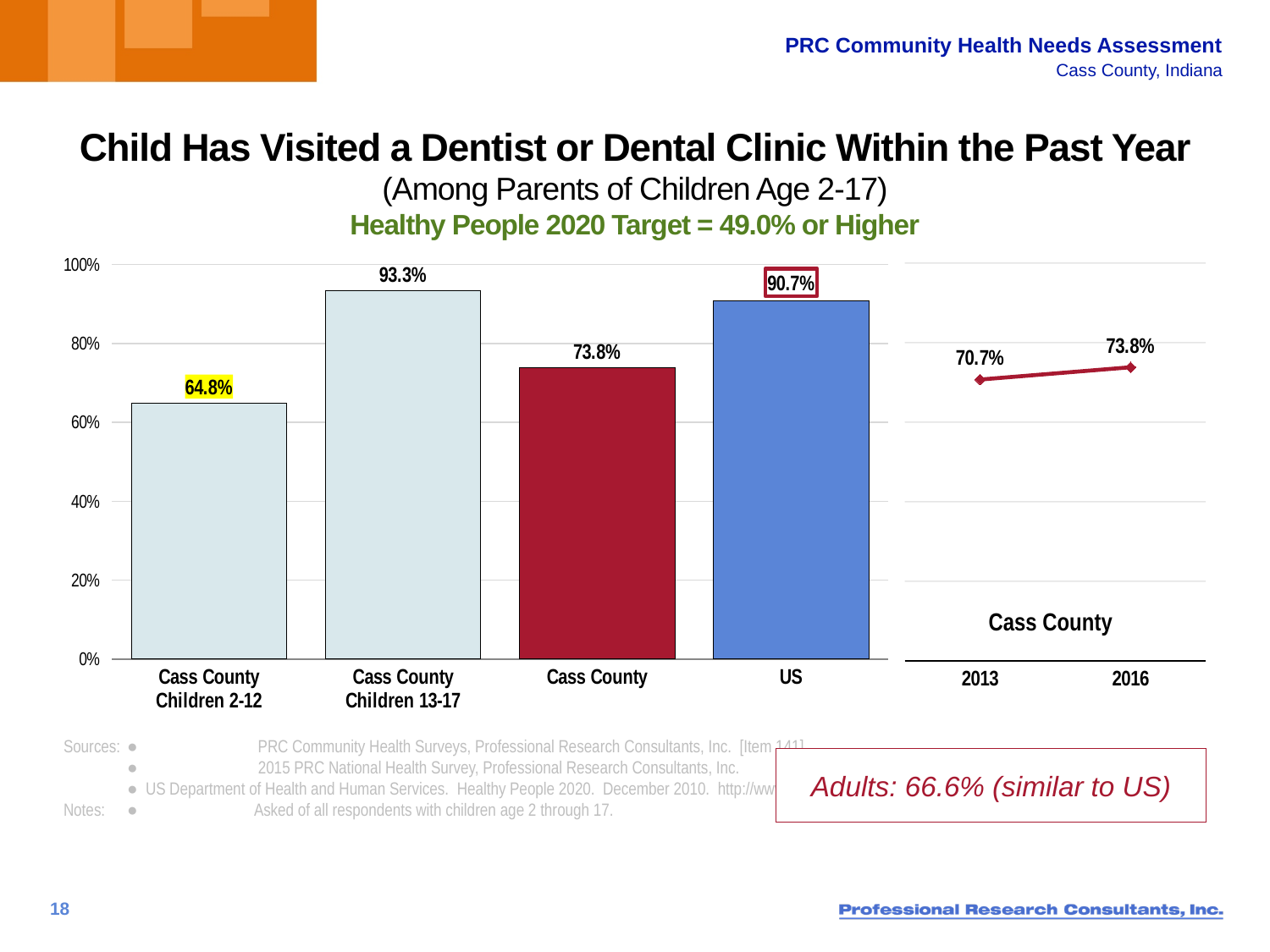
In the bar chart, which is larger: the value for Cass County Children 13-17 or the value for the US? Cass County Children 13-17 What kind of chart is the main chart on the left of the slide? Bar chart How many bars are in the bar chart? 4 In the bar chart, which category has the lowest value? Cass County Children 2-12 What is the Healthy People 2020 Target shown on the slide? 49.0% or Higher In the bar chart, what is the value for Cass County Children 13-17? 93.3% In the Cass County trend chart on the right, did the value rise or fall from 2013 to 2016? Rise In the bar chart, what is the difference between the US value and the Cass County value? 16.9% In the Cass County trend chart on the right, what is the value for 2013? 70.7% In the bar chart, which category has the highest value? Cass County Children 13-17 In the bar chart, what is the value for Cass County Children 2-12? 64.8% In the bar chart, what is the value for the US? 90.7%